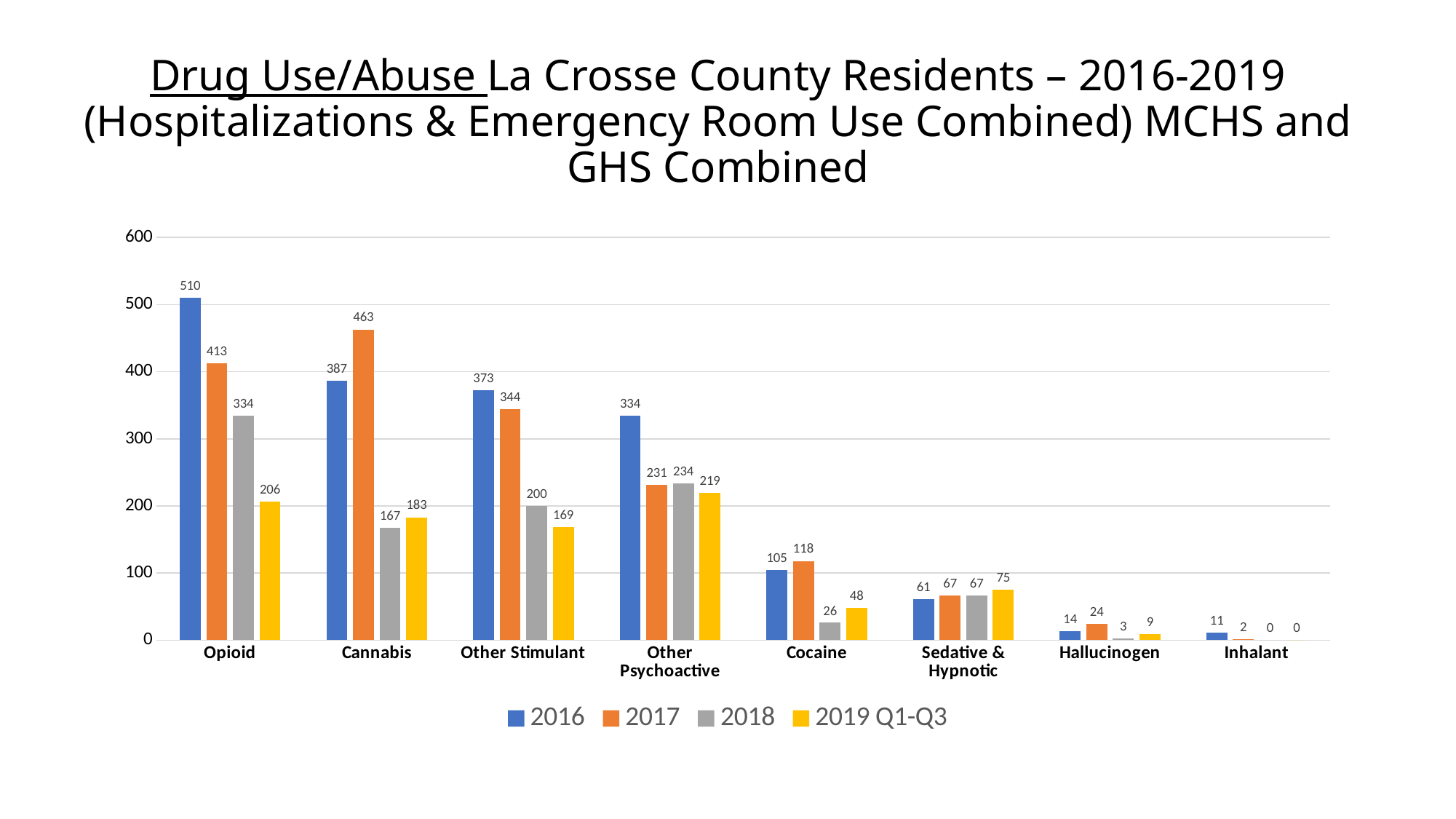
Do the Opioid values rise or fall from 2016 to 2019 Q1-Q3? Fall How many drug categories are shown on the x axis? 8 What is the difference between the 2016 and 2017 values for Opioid? 97 How many series does the legend list? 4 What kind of chart is shown on the slide? Bar chart Which drug category has the lowest 2017 value? Inhalant What is the 2016 value for Opioid? 510 Which is larger for Cannabis: the 2016 value or the 2017 value? 2017 What is the 2017 value for Cannabis? 463 Which drug category has the highest 2016 value? Opioid What is the 2019 Q1-Q3 value for Cocaine? 48 What is the 2018 value for Other Stimulant? 200